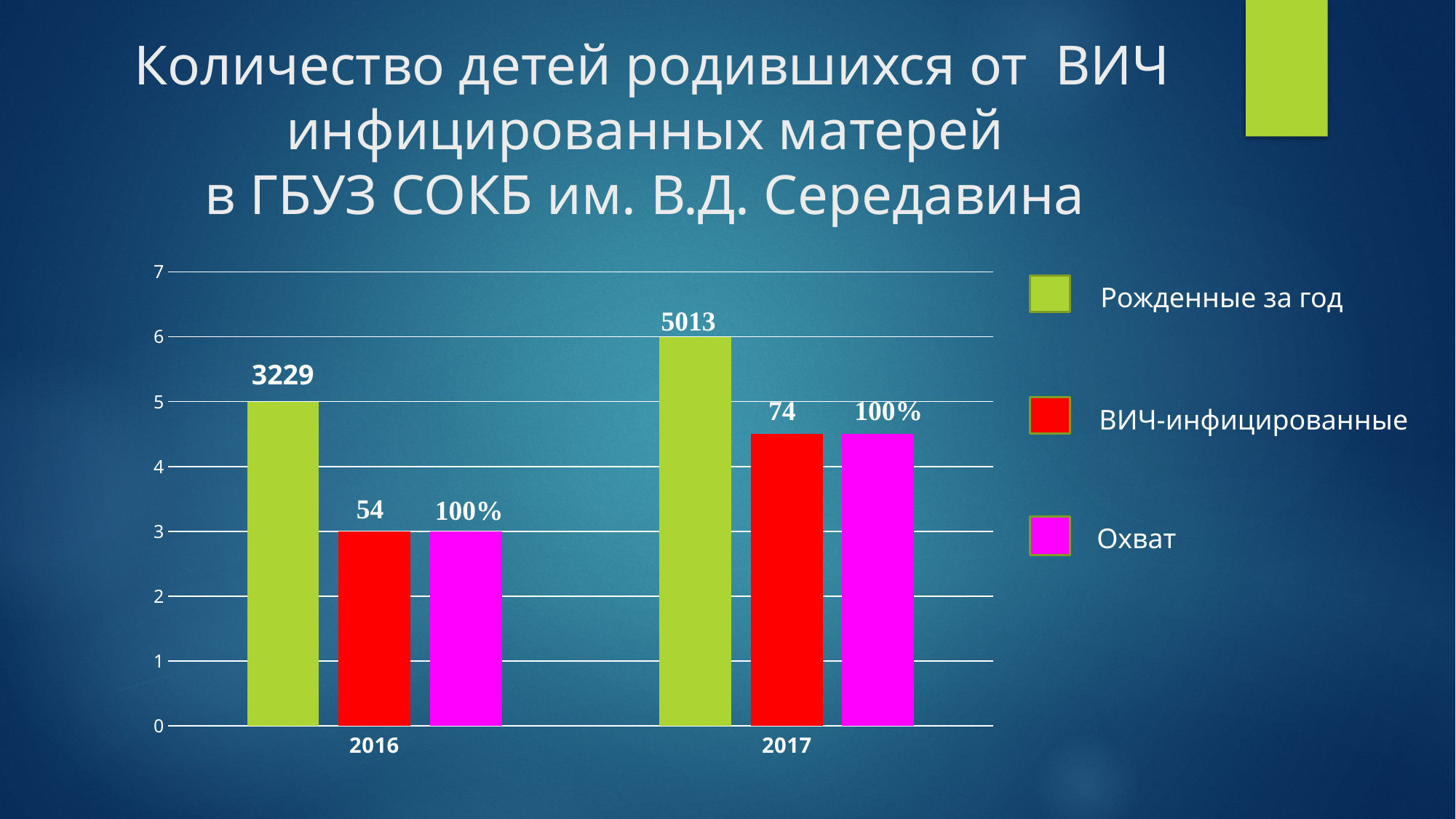
What is the value of Охват for 2017? 100% How many years are shown on the x axis? 2 What is the value of Рожденные за год for 2017? 5013 Which colour represents the Охват series in the legend? Magenta What is the difference between the ВИЧ-инфицированные values for 2017 and 2016? 20 What kind of chart is shown on the slide? Bar chart What is the value of ВИЧ-инфицированные for 2017? 74 What is the difference between the Рожденные за год values for 2017 and 2016? 1784 Which year has the larger value for ВИЧ-инфицированные, 2016 or 2017? 2017 What is the value of ВИЧ-инфицированные for 2016? 54 What is the value of Рожденные за год for 2016? 3229 How many series does the legend list? 3